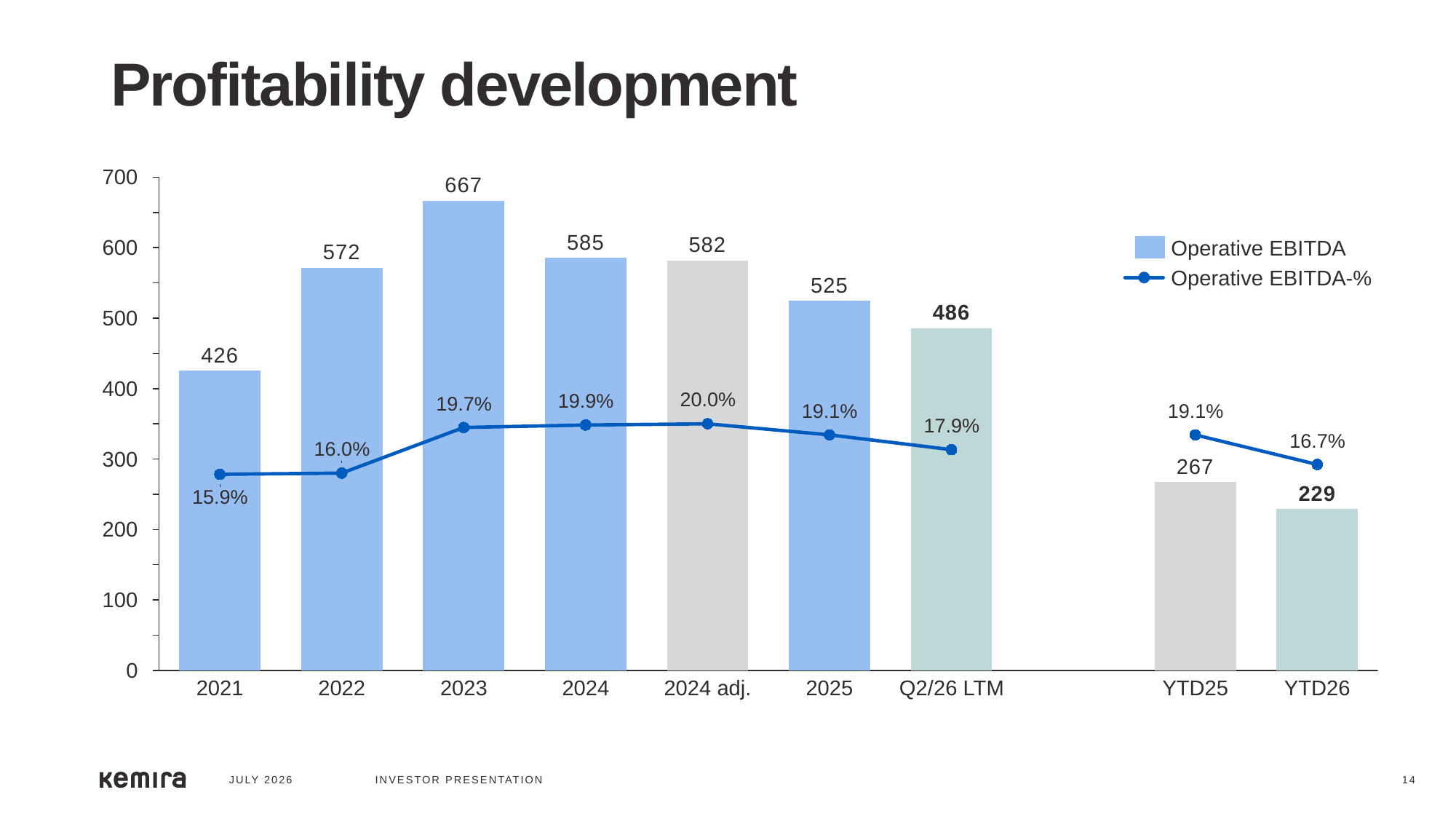
Which category has the lowest Operative EBITDA? YTD26 What is the Operative EBITDA for Q2/26 LTM? 486 What is the Operative EBITDA for 2023? 667 What kind of chart is this? Combined bar and line chart Which category has the highest Operative EBITDA? 2023 Does the Operative EBITDA-% rise or fall from 2024 adj. to Q2/26 LTM? Fall Which is larger, the Operative EBITDA for 2022 or for 2024? 2024 How many series does the legend list? 2 How many categories are shown on the x axis? 9 What is the difference in Operative EBITDA between 2023 and 2025? 142 What is the Operative EBITDA-% for YTD26? 16.7% What is the Operative EBITDA-% for 2024 adj.? 20.0%